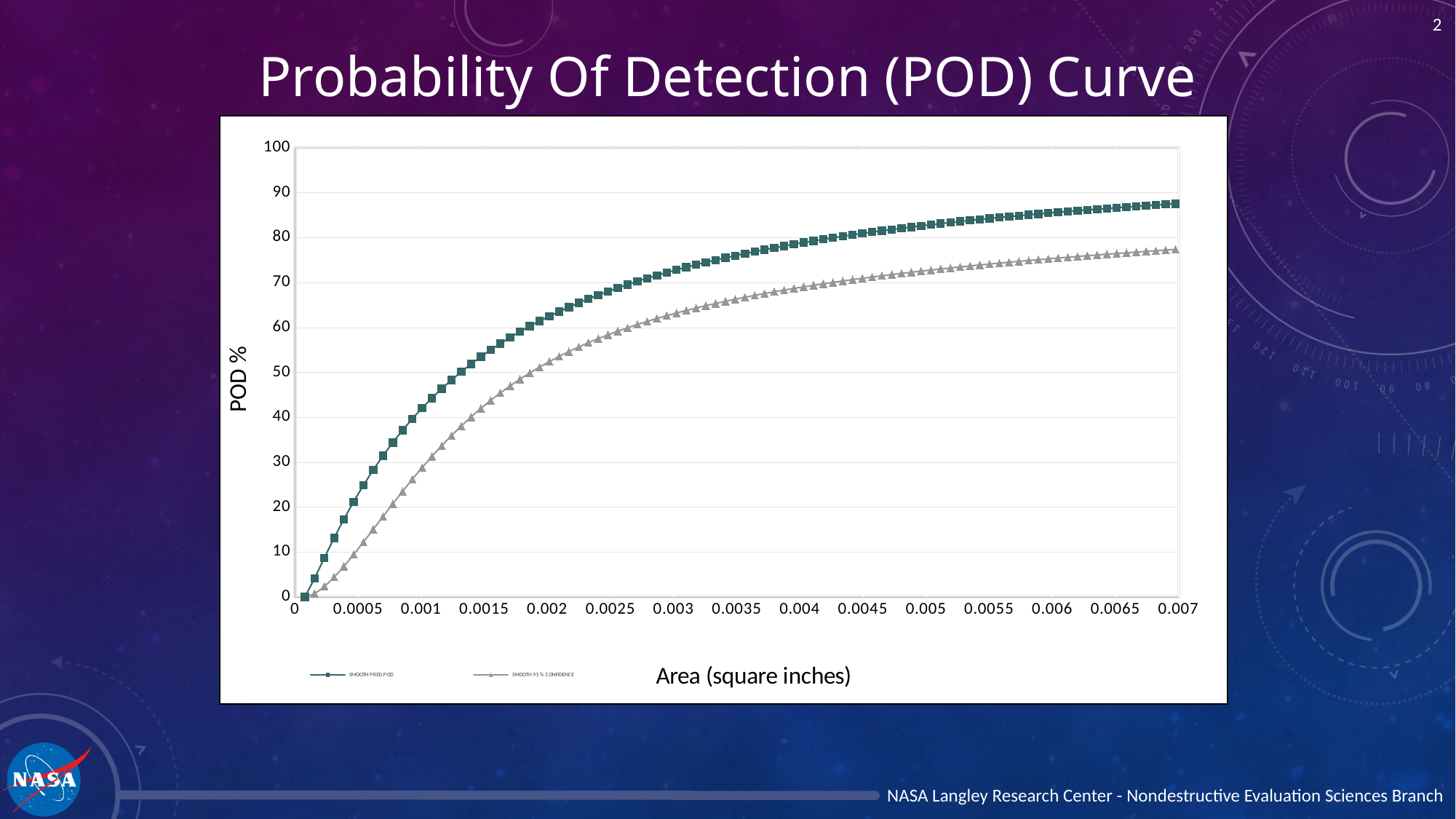
Is the value of the SMOOTH 95% CONFIDENCE series at an area of 0.007 greater or less than 80? less What is the title of the chart on the slide? Probability Of Detection (POD) Curve What is the label of the x axis? Area (square inches) At an area of 0.004, which series has the higher POD %, SMOOTH PRED.POD or SMOOTH 95% CONFIDENCE? SMOOTH PRED.POD Is the value of the SMOOTH 95% CONFIDENCE series at an area of 0.001 greater or less than 40? less Is the value of the SMOOTH PRED.POD series at an area of 0.003 greater or less than 70? greater Do the values of the SMOOTH PRED.POD series rise or fall as the area increases along the x axis? rise What is the maximum value shown on the POD % axis? 100 What kind of chart is shown on the slide? line chart How many series does the legend list? 2